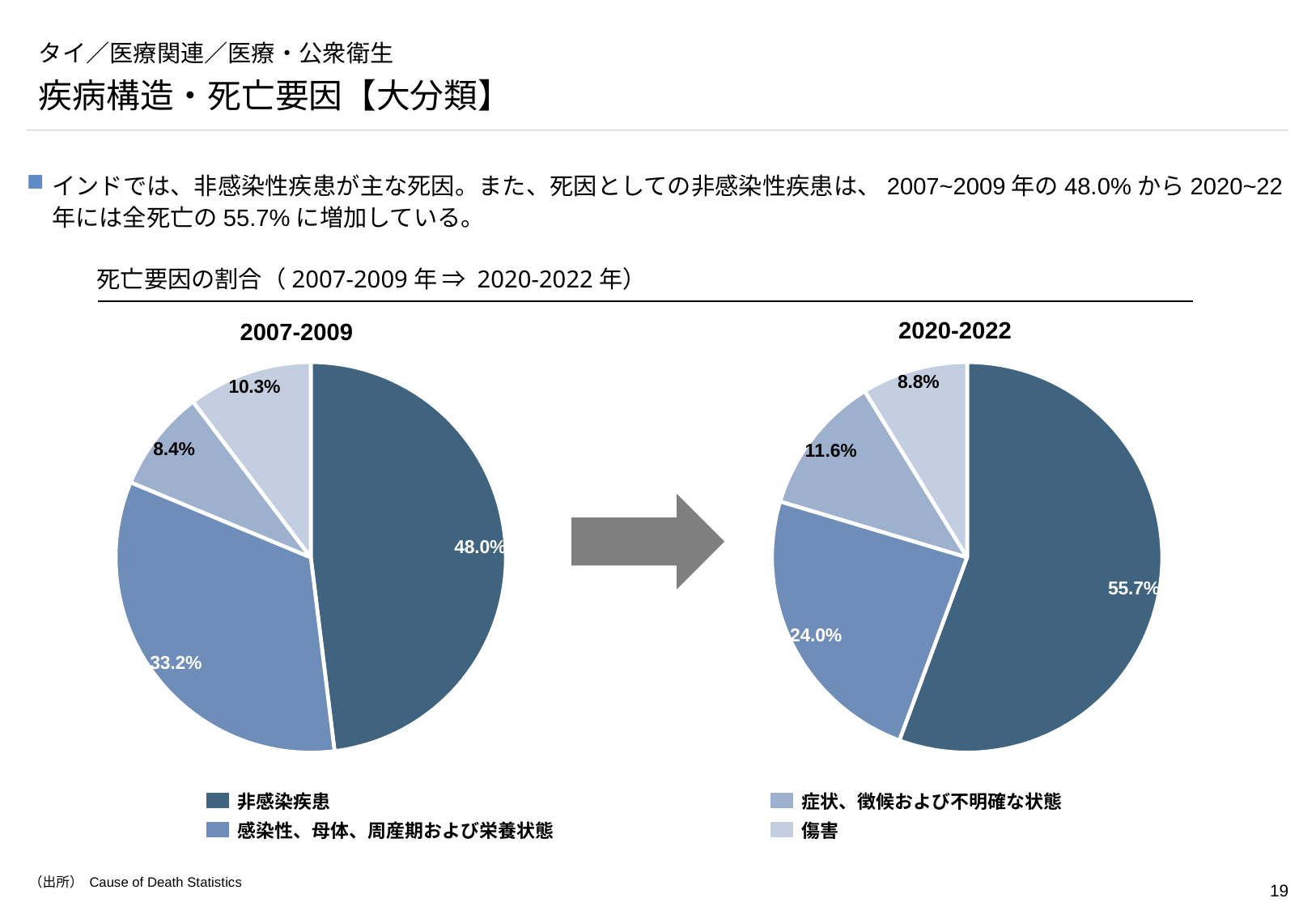
2007-2009年の円グラフで、感染性、母体、周産期および栄養状態の割合はいくらですか？ 33.2% 2020-2022年の円グラフで、傷害の割合はいくらですか？ 8.8% 2007-2009年の円グラフで、傷害と症状、徴候および不明確な状態では、どちらの割合が大きいですか？ 傷害 凡例にはいくつの区分が示されていますか？ 4 2007-2009年の円グラフで、最も割合が小さい区分はどれですか？ 症状、徴候および不明確な状態 2007-2009年の円グラフで、非感染疾患の割合はいくらですか？ 48.0% 非感染疾患の割合は、2007-2009年から2020-2022年で何ポイント増加しましたか？ 7.7ポイント 2020-2022年の円グラフで、症状、徴候および不明確な状態の割合はいくらですか？ 11.6% 2020-2022年の円グラフで、最も割合が小さい区分はどれですか？ 傷害 このスライドのグラフはどの種類のグラフですか？ 円グラフ 2020-2022年の円グラフで、非感染疾患の割合はいくらですか？ 55.7% 2007-2009年の円グラフで、最も割合が大きい区分はどれですか？ 非感染疾患